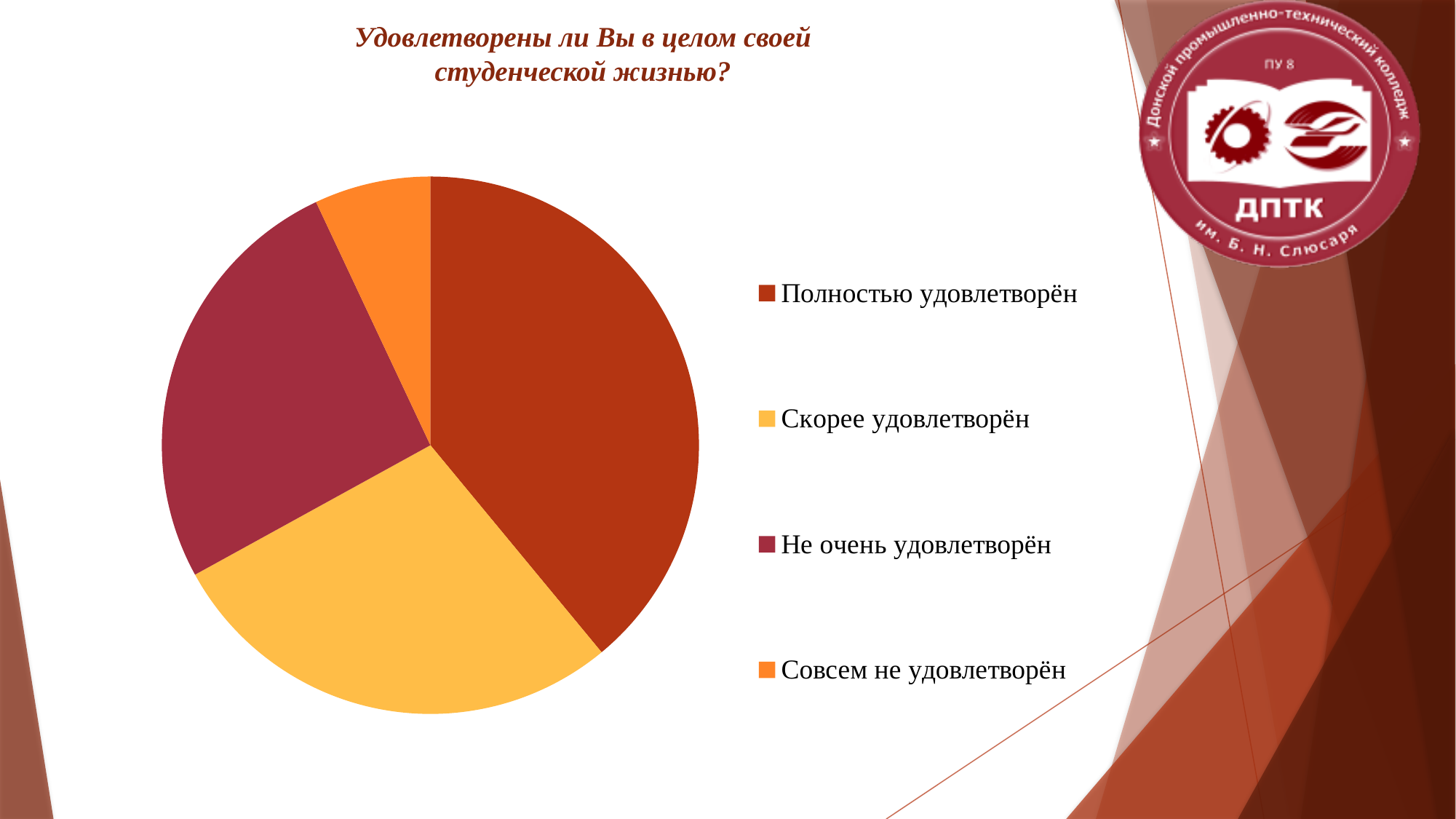
How many entries does the legend list? 4 Which slice is larger: "Полностью удовлетворён" or "Скорее удовлетворён"? Полностью удовлетворён Which category has the smallest slice of the pie? Совсем не удовлетворён Which category has the largest slice of the pie? Полностью удовлетворён Which category is shown in the yellow slice? Скорее удовлетворён What is the title of the chart? Удовлетворены ли Вы в целом своей студенческой жизнью? What kind of chart is shown on the slide? pie chart Which slice is larger: "Скорее удовлетворён" or "Совсем не удовлетворён"? Скорее удовлетворён How many categories (slices) does the pie chart have? 4 Which slice is larger: "Не очень удовлетворён" or "Совсем не удовлетворён"? Не очень удовлетворён